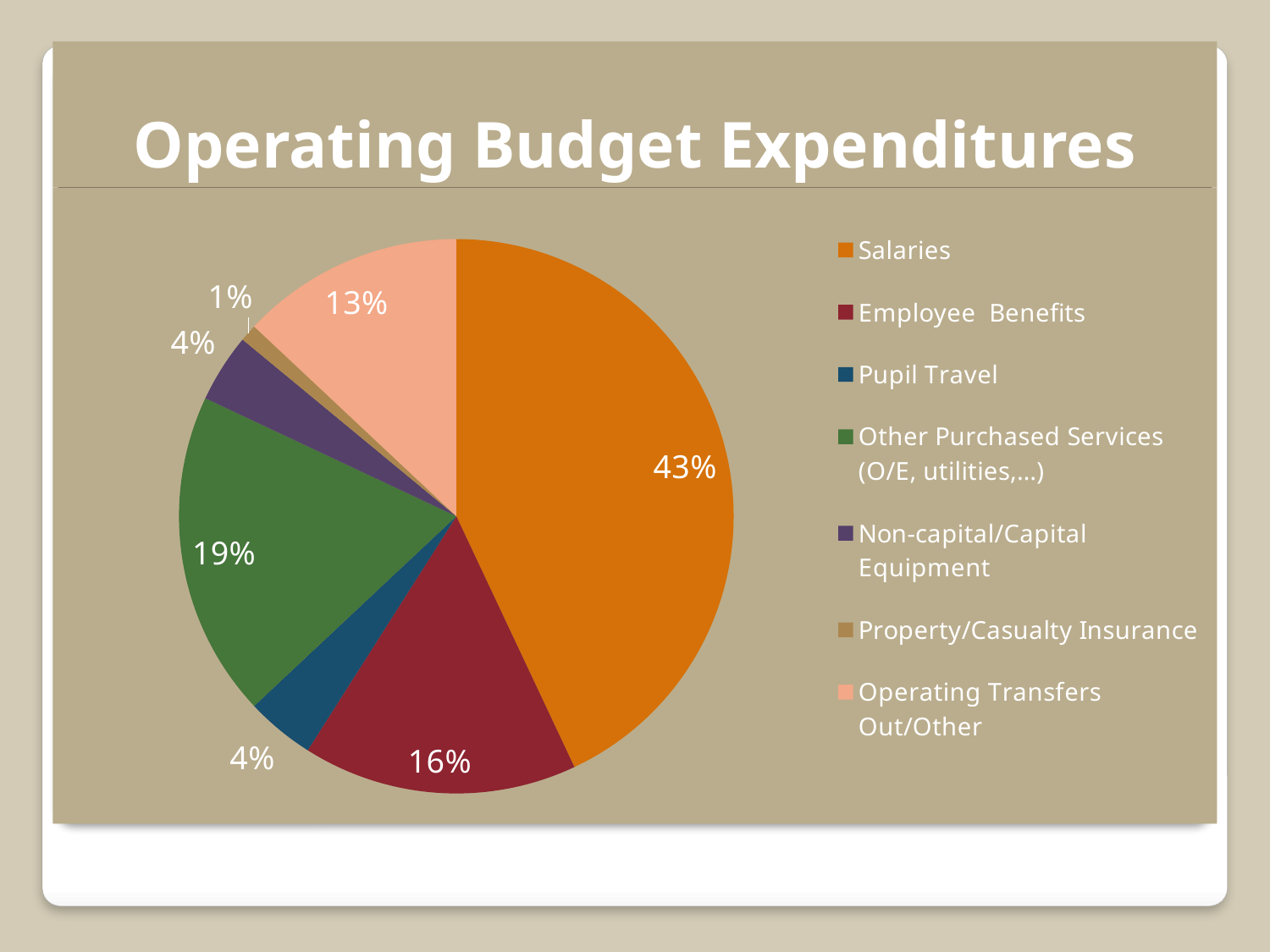
What is the title of the slide? Operating Budget Expenditures What percentage is shown for Other Purchased Services (O/E, utilities,...)? 19% What percentage is shown for Property/Casualty Insurance? 1% What kind of chart is shown on the slide? Pie chart Which category has the largest share of the pie? Salaries What share of the pie does Salaries represent? 43% Which is larger, Other Purchased Services (O/E, utilities,...) or Operating Transfers Out/Other? Other Purchased Services (O/E, utilities,...) What is the difference in percentage points between Salaries and Employee Benefits? 27 How many categories does the legend list? 7 What percentage is shown for Operating Transfers Out/Other? 13% What percentage is shown for Employee Benefits? 16% Which category has the smallest share of the pie? Property/Casualty Insurance